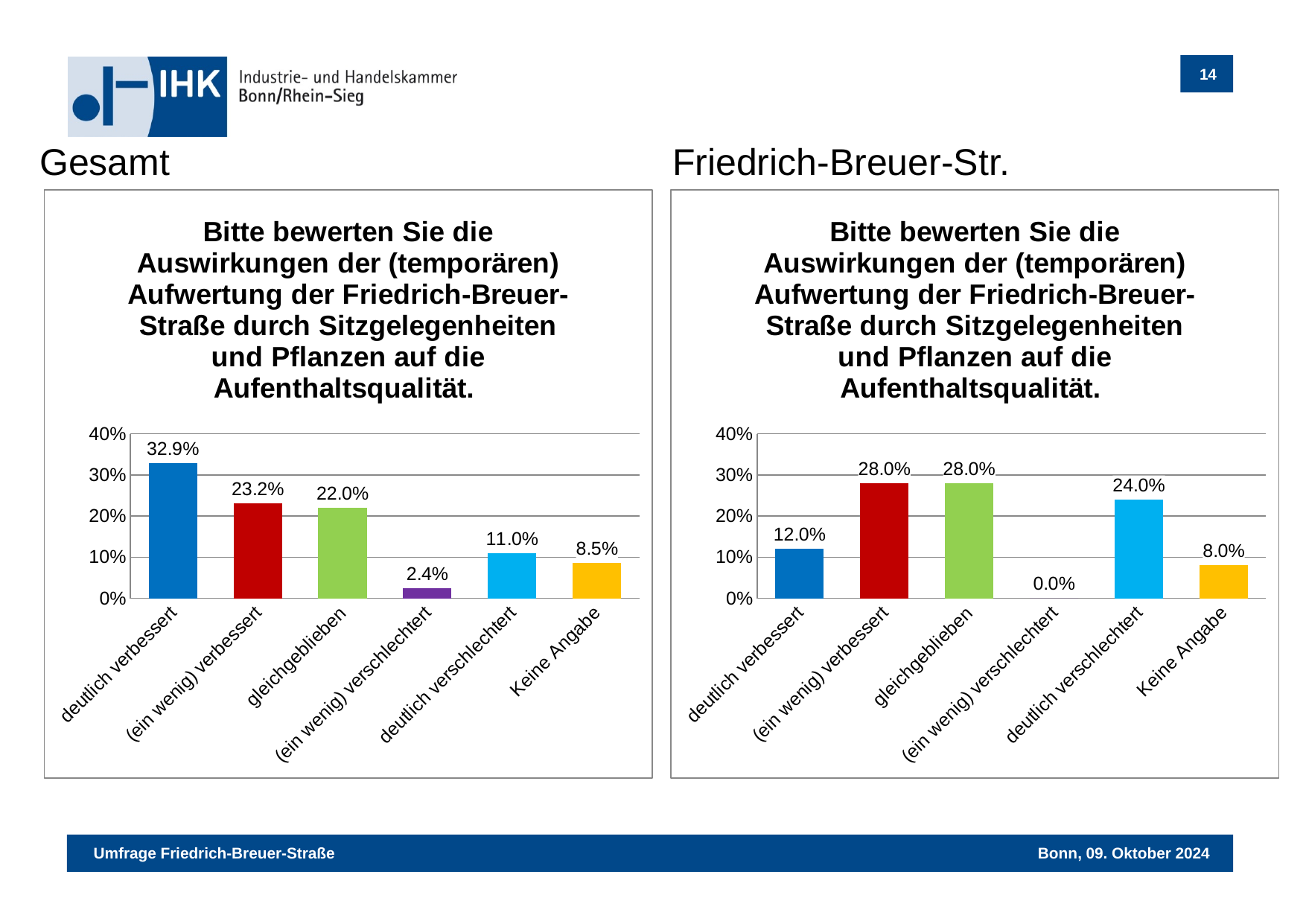
In the Friedrich-Breuer-Str. chart, what is the value for "deutlich verschlechtert"? 24.0% In the Friedrich-Breuer-Str. chart, which category has the lowest value? (ein wenig) verschlechtert What kind of chart is the Friedrich-Breuer-Str. chart? bar chart In the Friedrich-Breuer-Str. chart, what is the difference between "deutlich verschlechtert" and "deutlich verbessert"? 12.0% In the Gesamt chart, which category has the highest value? deutlich verbessert In the Gesamt chart, what is the value for "deutlich verbessert"? 32.9% In the Gesamt chart, what is the difference between "deutlich verbessert" and "(ein wenig) verbessert"? 9.7% In the Gesamt chart, what colour is the bar for "Keine Angabe"? yellow In the Gesamt chart, is the value for "gleichgeblieben" greater or less than 20%? greater How many categories does the Gesamt chart show? 6 In the Gesamt chart, which category has the lowest value? (ein wenig) verschlechtert In the Friedrich-Breuer-Str. chart, which is larger: "deutlich verschlechtert" or "Keine Angabe"? deutlich verschlechtert